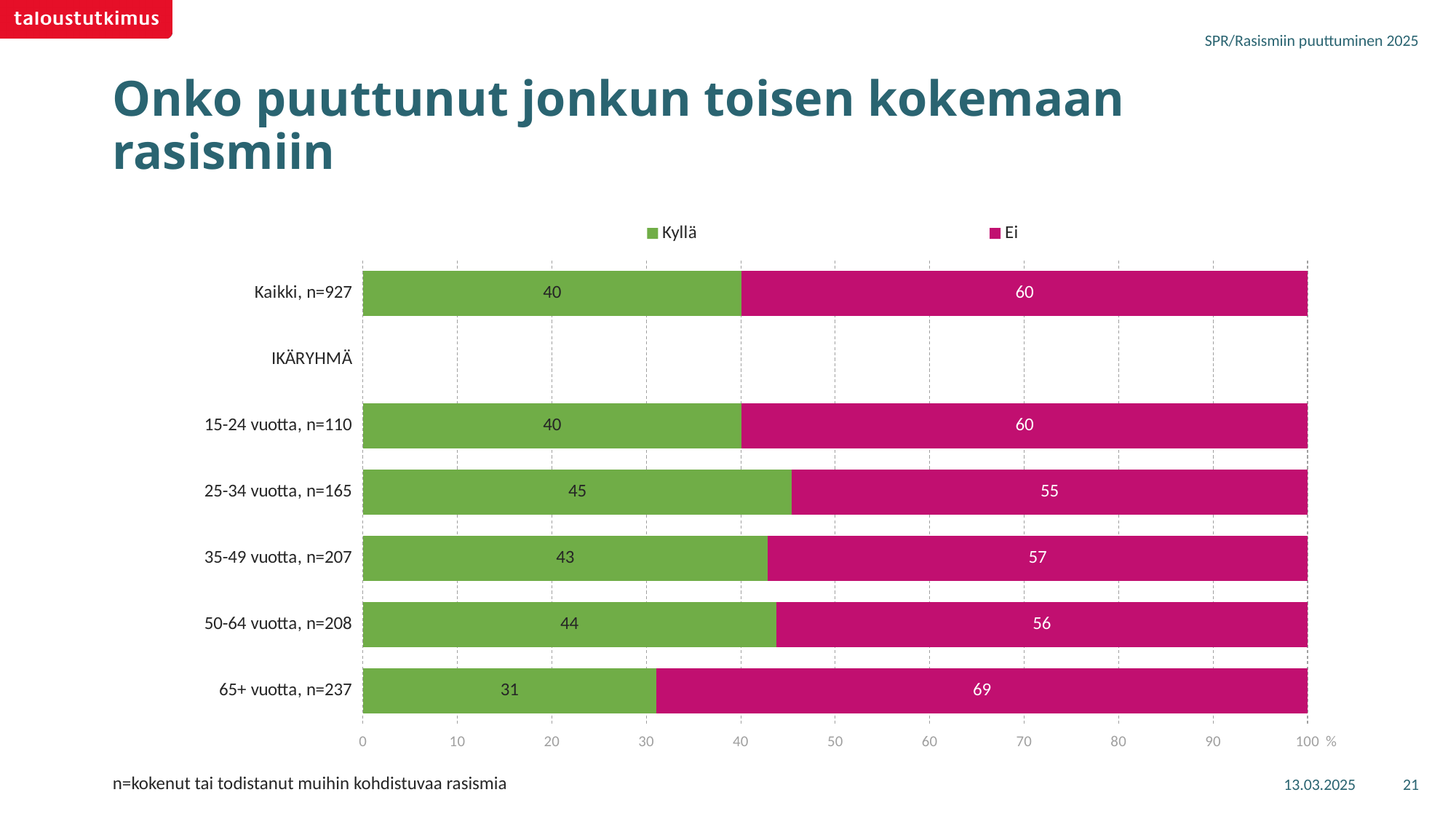
What kind of chart is shown on the slide? Stacked bar chart What is the Kyllä value for 25-34 vuotta, n=165? 45 Which age group has the highest Kyllä value? 25-34 vuotta, n=165 What is the difference between the Ei value for 65+ vuotta, n=237 and the Ei value for 25-34 vuotta, n=165? 14 Which is larger: the Kyllä value for 35-49 vuotta, n=207 or the Kyllä value for 50-64 vuotta, n=208? 50-64 vuotta, n=208 Which age group has the lowest Kyllä value? 65+ vuotta, n=237 What is the Kyllä value for Kaikki, n=927? 40 How many age groups (excluding Kaikki) have bars plotted in the chart? 5 What is the Ei value for 65+ vuotta, n=237? 69 What is the total of the stacked bar for 15-24 vuotta, n=110? 100 What colour represents the Ei series in the chart? Magenta/pink How many series does the legend list? 2